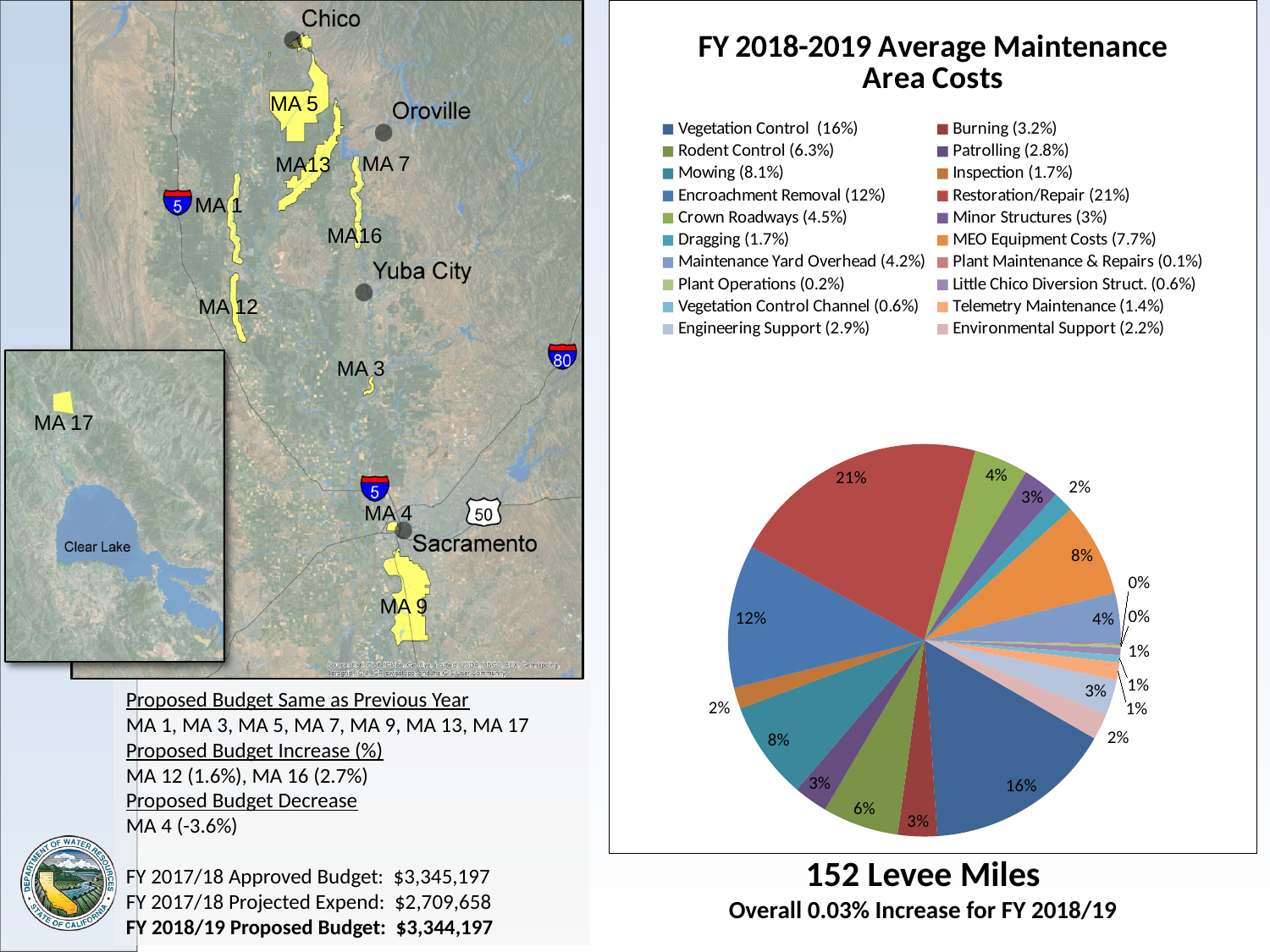
Which category has the largest share of the pie chart? Restoration/Repair What is the title of the pie chart? FY 2018-2019 Average Maintenance Area Costs What is the difference in percentage points between Restoration/Repair (21%) and Vegetation Control (16%)? 5% Which is larger, Encroachment Removal or MEO Equipment Costs? Encroachment Removal Which category has the smallest share of the pie chart? Plant Maintenance & Repairs What percentage is shown for Mowing in the legend? 8.1% What is the difference in percentage points between Mowing (8.1%) and Rodent Control (6.3%)? 1.8% What percentage is shown for MEO Equipment Costs in the legend? 7.7% How many categories does the pie chart's legend list? 20 What percentage is shown for Vegetation Control in the legend? 16% What kind of chart is shown on the slide? pie chart What share of the pie does Restoration/Repair account for? 21%